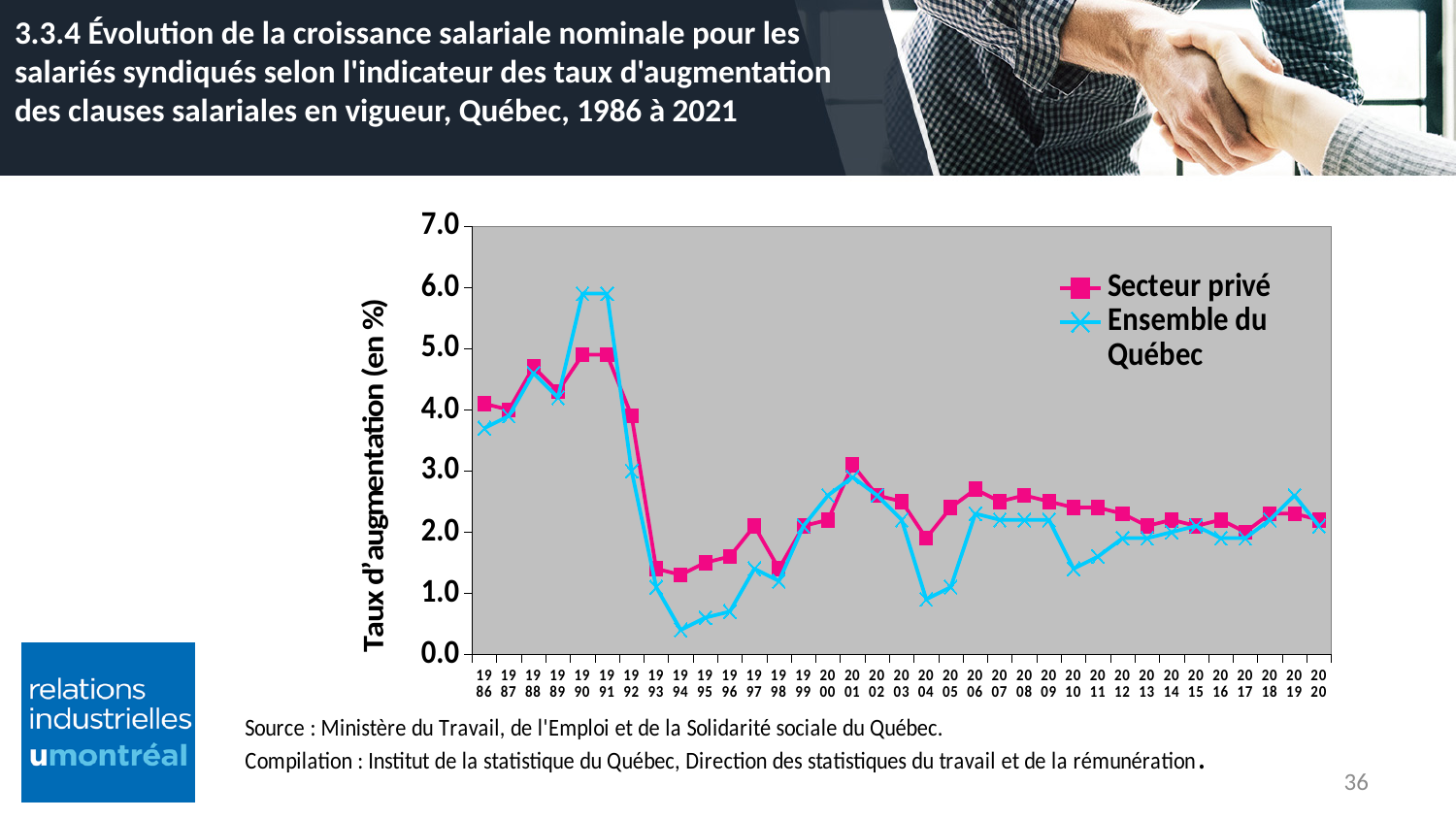
Is the value for Ensemble du Québec in 1991 greater or less than 5.0? greater In 1991, which series has the higher value, Secteur privé or Ensemble du Québec? Ensemble du Québec Is the value for Ensemble du Québec in 2010 greater or less than 2.0? less In 2004, which series has the higher value, Secteur privé or Ensemble du Québec? Secteur privé What is the title of the vertical axis? Taux d'augmentation (en %) How many years are plotted along the x axis? 35 Is the value for Secteur privé in 1994 greater or less than 2.0? less Does the Secteur privé series rise or fall between 1991 and 1994? fall Which year has the lowest value for the Ensemble du Québec series? 1994 How many series does the legend list? 2 What kind of chart is shown on the slide? line chart